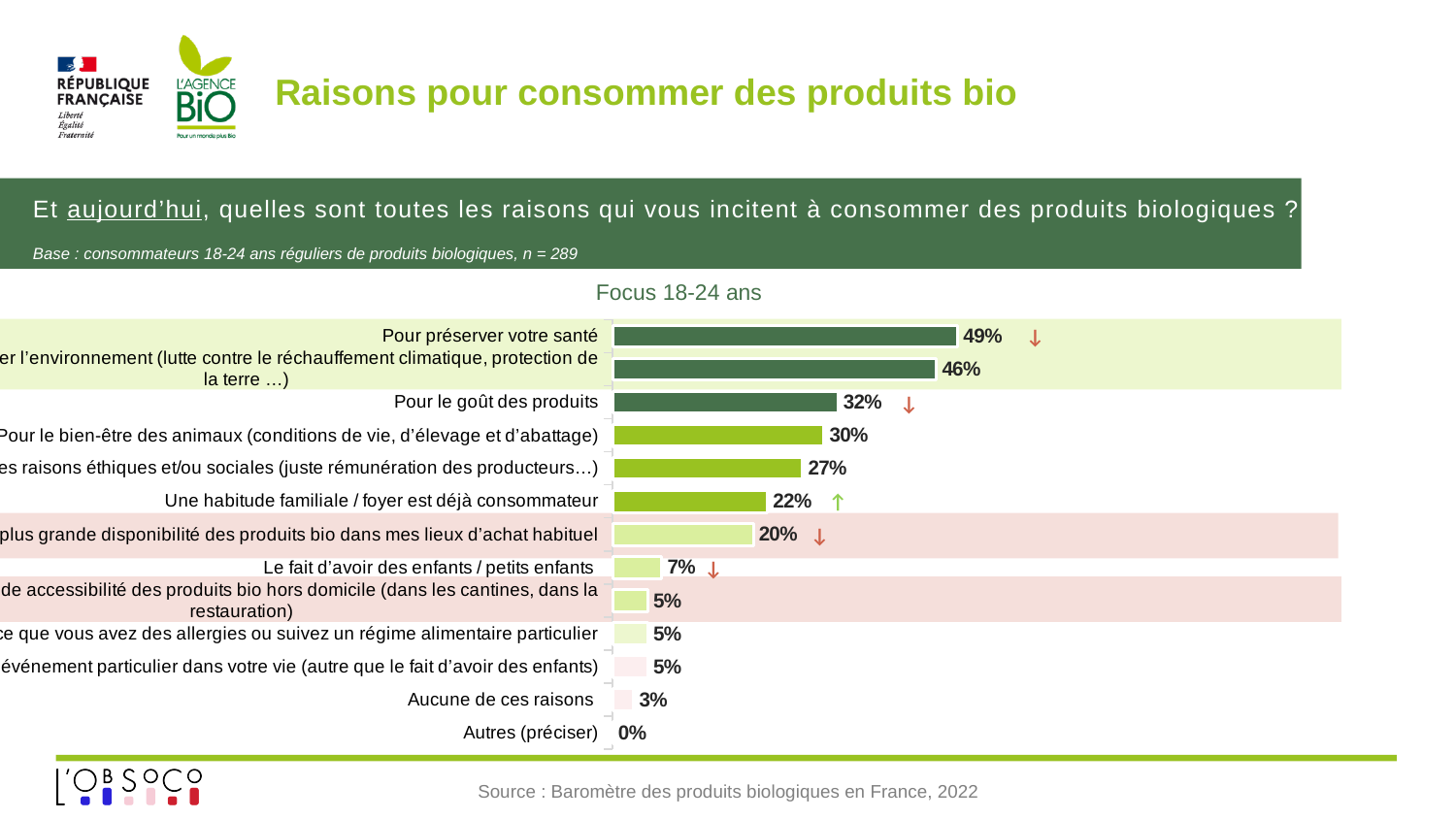
Which is larger: "Pour le bien-être des animaux (conditions de vie, d'élevage et d'abattage)" or "Une habitude familiale / foyer est déjà consommateur"? Pour le bien-être des animaux (conditions de vie, d'élevage et d'abattage) What is the value for "Le fait d'avoir des enfants / petits enfants"? 7% What is the subtitle shown above the chart? Focus 18-24 ans What kind of chart is shown on the slide? Bar chart What is the value for "Pour préserver votre santé"? 49% Which category has the highest value? Pour préserver votre santé What is the value for "Aucune de ces raisons"? 3% What is the difference between "Pour préserver votre santé" and "Pour le goût des produits"? 17% How many categories are shown in the chart? 13 What is the value for "Pour le goût des produits"? 32% What is the value for "Une habitude familiale / foyer est déjà consommateur"? 22% Which category has the lowest value? Autres (préciser)